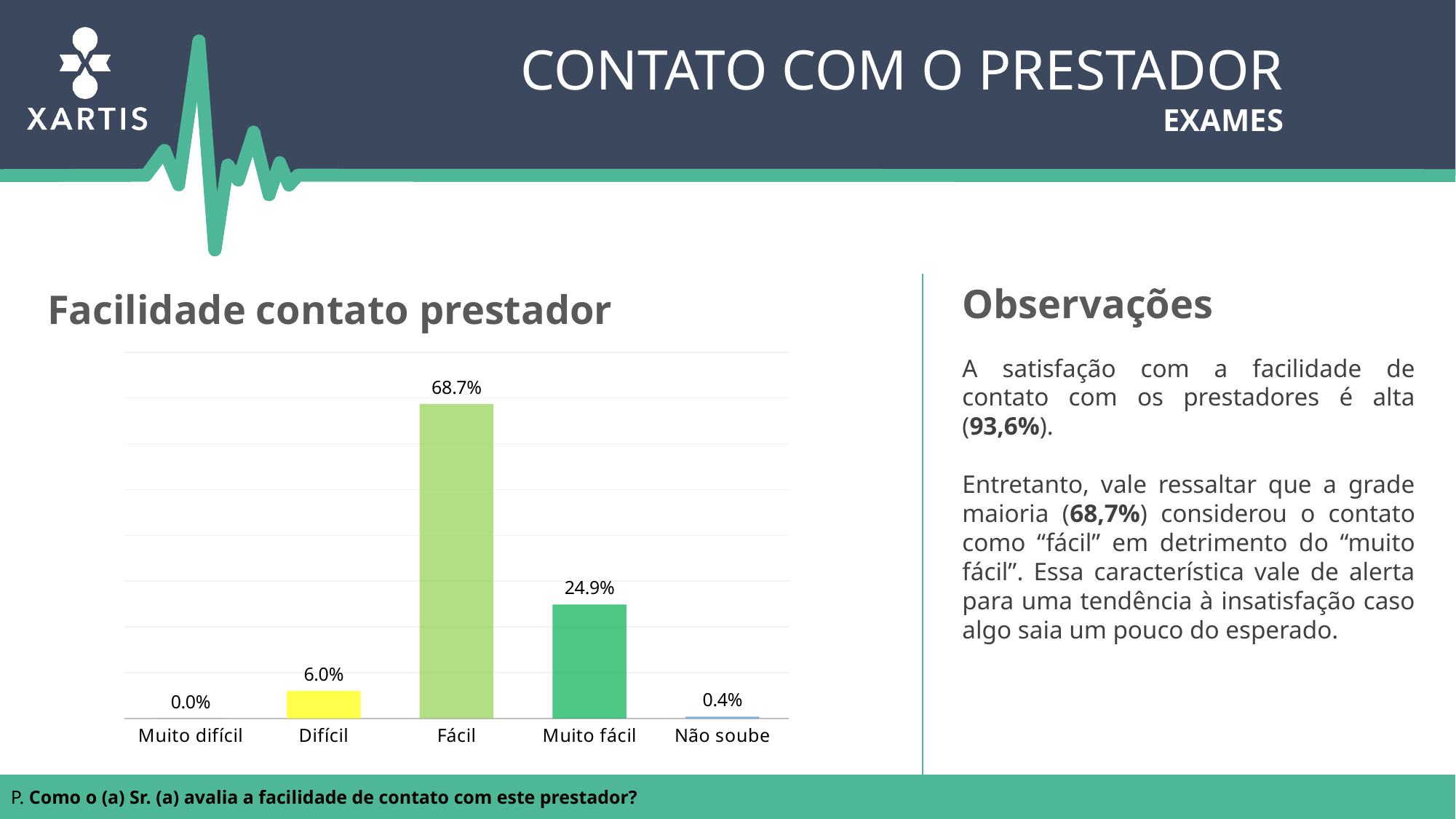
What is the value for "Fácil" in the chart? 68.7% What is the value for "Muito fácil" in the chart? 24.9% Which category has the highest value in the chart? Fácil Which is larger, the value for "Difícil" or the value for "Não soube"? Difícil What is the value for "Não soube" in the chart? 0.4% Which category has the lowest value in the chart? Muito difícil What is the combined value of "Fácil" and "Muito fácil"? 93.6% How many categories are shown on the x axis of the chart? 5 What is the value for "Difícil" in the chart? 6.0% What is the difference between the values for "Fácil" and "Muito fácil"? 43.8% What is the title of the chart on the slide? Facilidade contato prestador What type of chart is shown on the slide? Bar chart